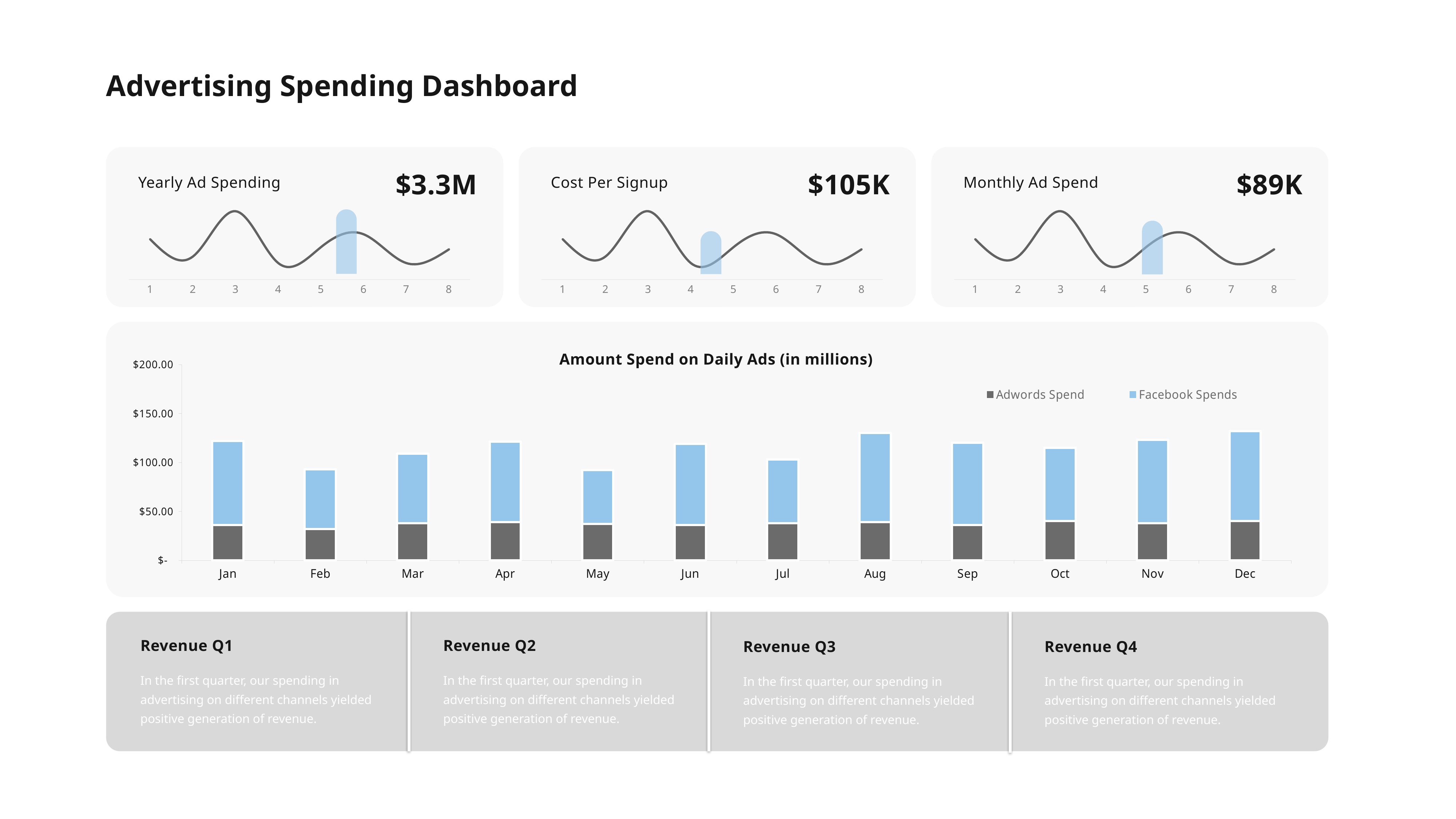
How many series does the legend of the 'Amount Spend on Daily Ads (in millions)' chart list? 2 In the 'Amount Spend on Daily Ads (in millions)' chart, which month has the larger total stacked bar, Jul or Aug? Aug What value is displayed on the 'Monthly Ad Spend' card at the top right of the slide? $89K In the 'Amount Spend on Daily Ads (in millions)' chart, which month has the larger total stacked bar, Jan or Feb? Jan In the 'Amount Spend on Daily Ads (in millions)' chart, is the total stacked value for Jan greater or less than $100.00? greater How many months are shown on the x axis of the 'Amount Spend on Daily Ads (in millions)' chart? 12 In the 'Amount Spend on Daily Ads (in millions)' chart, is the total stacked value for Feb greater or less than $100.00? less What kind of chart is 'Amount Spend on Daily Ads (in millions)'? Stacked bar chart In the 'Amount Spend on Daily Ads (in millions)' chart, which series is shown in blue? Facebook Spends In the 'Amount Spend on Daily Ads (in millions)' chart, is the Adwords Spend value for Apr greater or less than $50.00? less What value is displayed on the 'Yearly Ad Spending' card at the top left of the slide? $3.3M